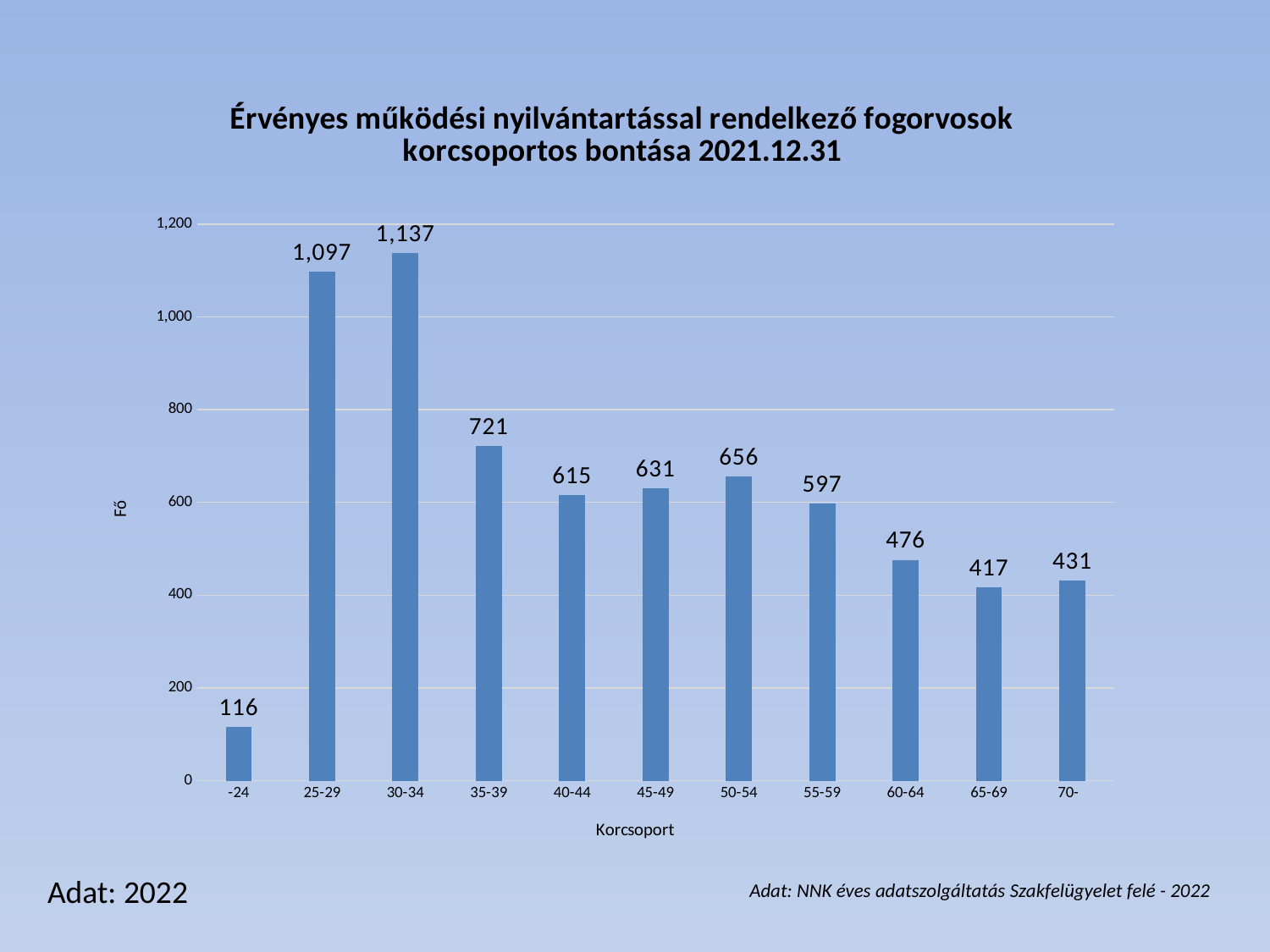
Do the values rise or fall from the 35-39 group to the 40-44 group? fall What is the value for the 55-59 age group? 597 Is the value for 50-54 greater or less than 600? greater What is the value for the -24 age group? 116 How many age groups are shown on the x axis? 11 What is the value for the 30-34 age group? 1,137 What is the difference between the values for 25-29 and 35-39? 376 What kind of chart is shown on the slide? bar chart Which age group has the lowest value? -24 What is the label of the y axis? Fő Which age group has the highest value? 30-34 Which is larger, the value for 60-64 or the value for 70-? 60-64